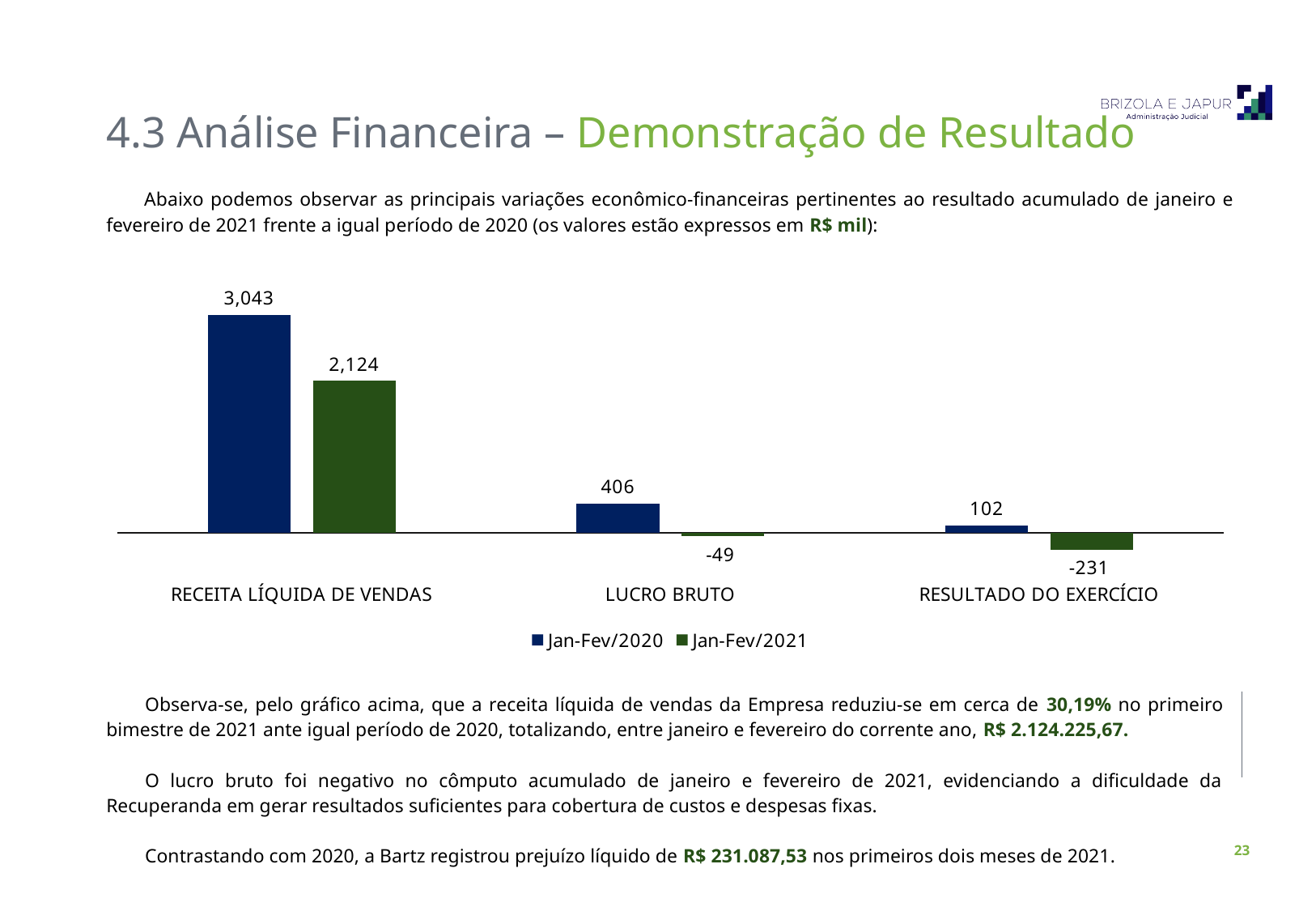
Which category has the highest value in the Jan-Fev/2020 series? RECEITA LÍQUIDA DE VENDAS What is the value for RECEITA LÍQUIDA DE VENDAS in the Jan-Fev/2020 series? 3,043 What is the difference between the Jan-Fev/2020 and Jan-Fev/2021 values for LUCRO BRUTO? 455 How many categories are shown on the x axis of the chart? 3 Which category has the lowest value in the Jan-Fev/2021 series? RESULTADO DO EXERCÍCIO Which is larger for RESULTADO DO EXERCÍCIO: the Jan-Fev/2020 value or the Jan-Fev/2021 value? Jan-Fev/2020 What kind of chart is shown on the slide? Bar chart How many series does the chart legend list? 2 What is the value for RECEITA LÍQUIDA DE VENDAS in the Jan-Fev/2021 series? 2,124 What is the difference between the Jan-Fev/2020 and Jan-Fev/2021 values for RECEITA LÍQUIDA DE VENDAS? 919 What is the value for RESULTADO DO EXERCÍCIO in the Jan-Fev/2020 series? 102 What is the value for LUCRO BRUTO in the Jan-Fev/2021 series? -49